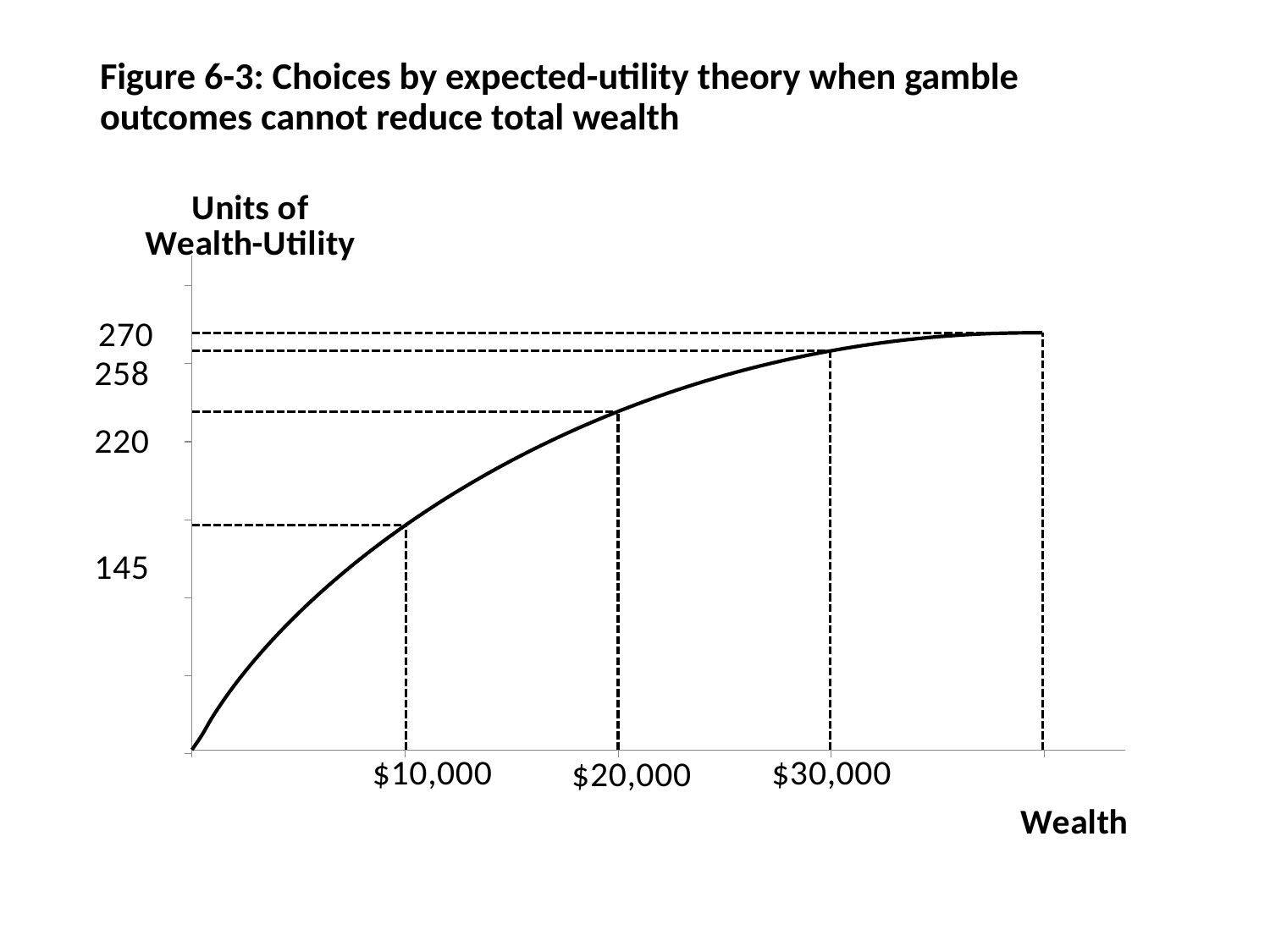
What is the difference in utility between a wealth of $20,000 and a wealth of $10,000? 75 What is the utility value at a wealth of $20,000? 220 What kind of chart is shown on the slide? line chart What is the utility value at a wealth of $30,000? 258 Which wealth level has the higher utility, $10,000 or $30,000? $30,000 What is the difference in utility between a wealth of $30,000 and a wealth of $20,000? 38 What is the label of the x axis? Wealth What is the label of the y axis? Units of Wealth-Utility Does the utility curve rise or fall as wealth increases along the x axis? rises What is the highest utility value labeled on the y axis? 270 What is the utility value (in units of wealth-utility) at a wealth of $10,000? 145 How many wealth values are labeled on the x axis? 3